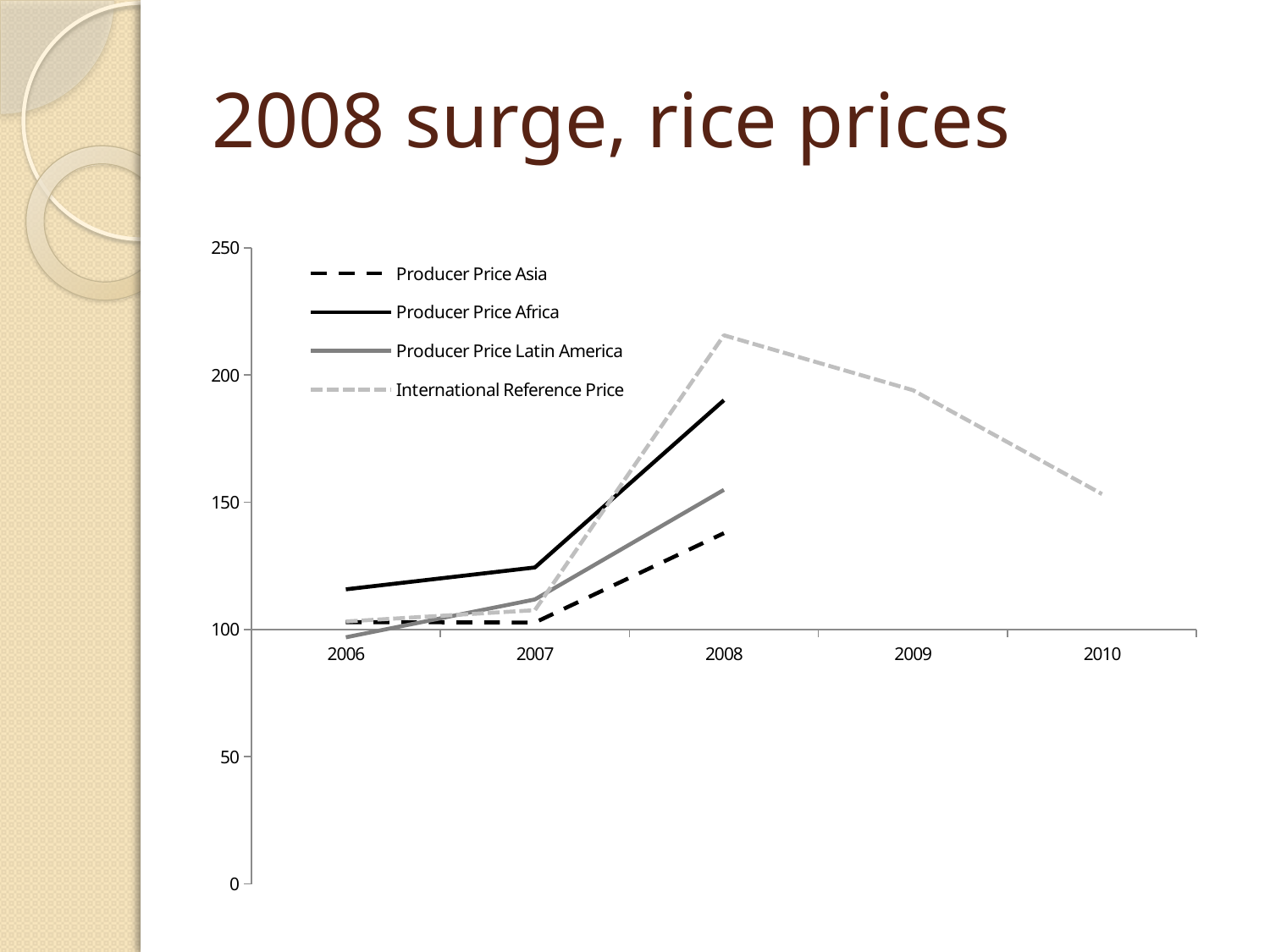
Does the International Reference Price rise or fall from 2008 to 2010? fall What kind of chart is shown on the slide? line chart Is the value for International Reference Price in 2010 greater or less than 200? less What is the title of the slide? 2008 surge, rice prices How many series does the legend list? 4 Which series has the lowest value in 2008? Producer Price Asia Which series has the highest value in 2008? International Reference Price In 2008, which is larger: Producer Price Africa or Producer Price Latin America? Producer Price Africa Is the value for International Reference Price in 2008 greater or less than 200? greater How many years are shown on the x axis? 5 Is the value for Producer Price Asia in 2008 greater or less than 150? less